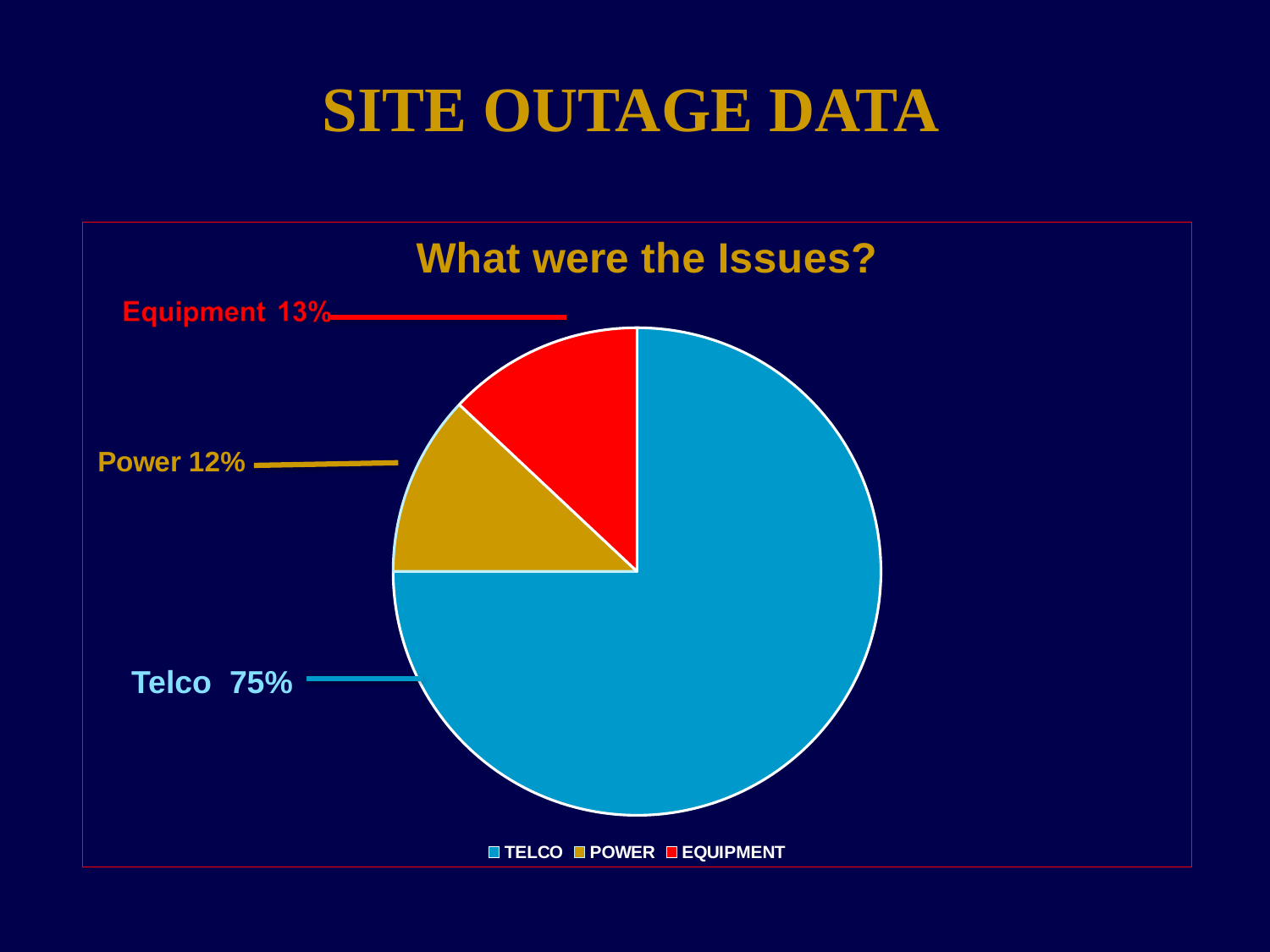
What share of the pie does Equipment account for? 13% Which is larger, the Power slice or the Telco slice? Telco How many entries does the legend list? 3 How many slices does the pie chart have? 3 What colour is the Equipment slice? red What share of the pie does Power account for? 12% What share of the pie does Telco account for? 75% Which category has the smallest slice of the pie? Power What type of chart is shown on the slide? pie chart Which category has the largest slice of the pie? Telco What is the difference in percentage points between Telco and Equipment? 62 What is the chart's title? What were the Issues?